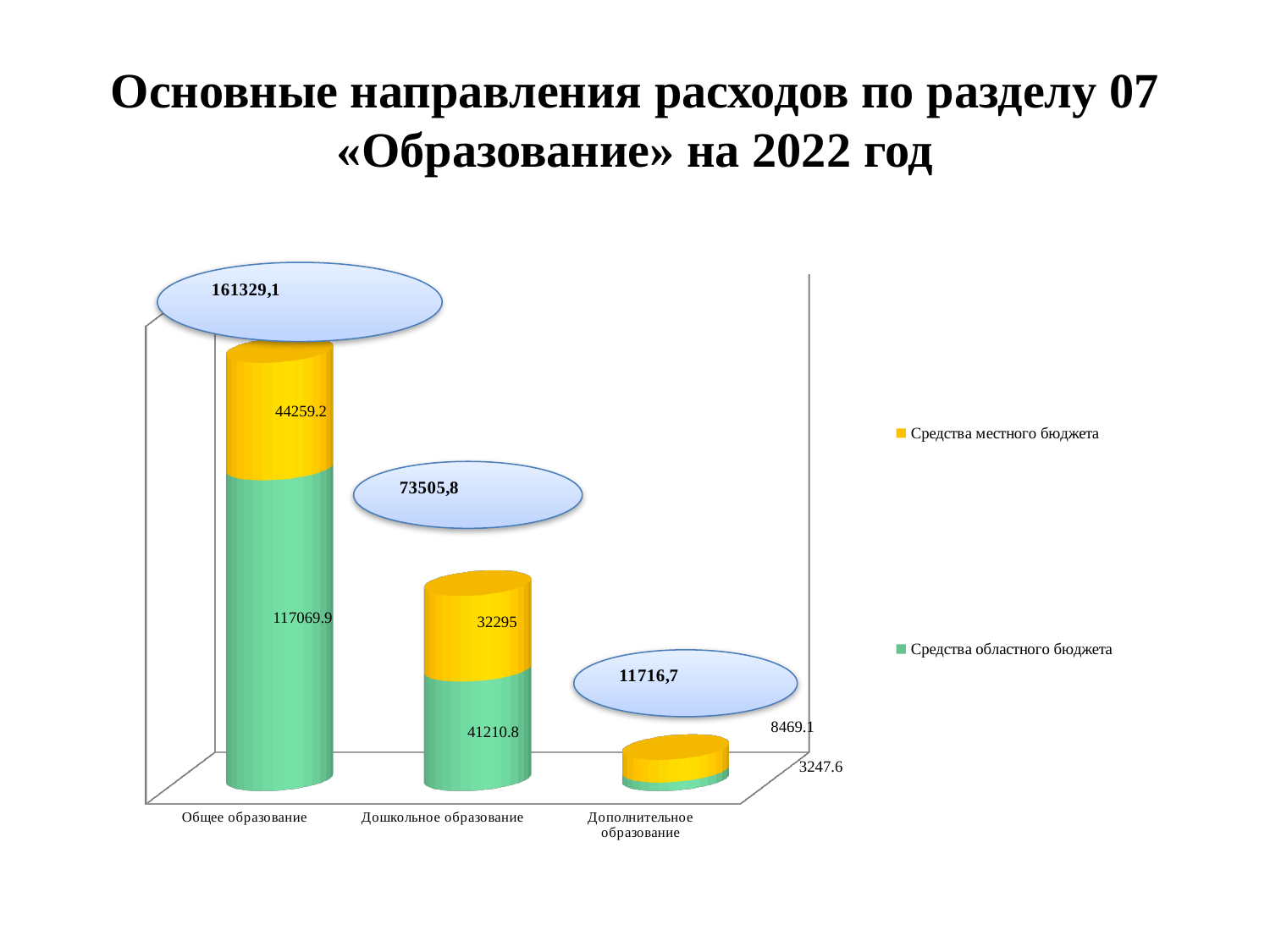
What is the value of Средства местного бюджета for Дошкольное образование? 32295 What is the value of Средства областного бюджета for Общее образование? 117069.9 Which category has the highest total expenditure? Общее образование What is the value of Средства местного бюджета for Дополнительное образование? 8469.1 Which category has the lowest total expenditure? Дополнительное образование What is the value of Средства областного бюджета for Дополнительное образование? 3247.6 What is the difference between Средства областного бюджета and Средства местного бюджета for Общее образование? 72810.7 How many series does the legend list? 2 How many categories are shown on the x axis? 3 For Дополнительное образование, which is larger: Средства местного бюджета or Средства областного бюджета? Средства местного бюджета What is the total shown for Общее образование? 161329,1 What is the total shown for Дошкольное образование? 73505,8